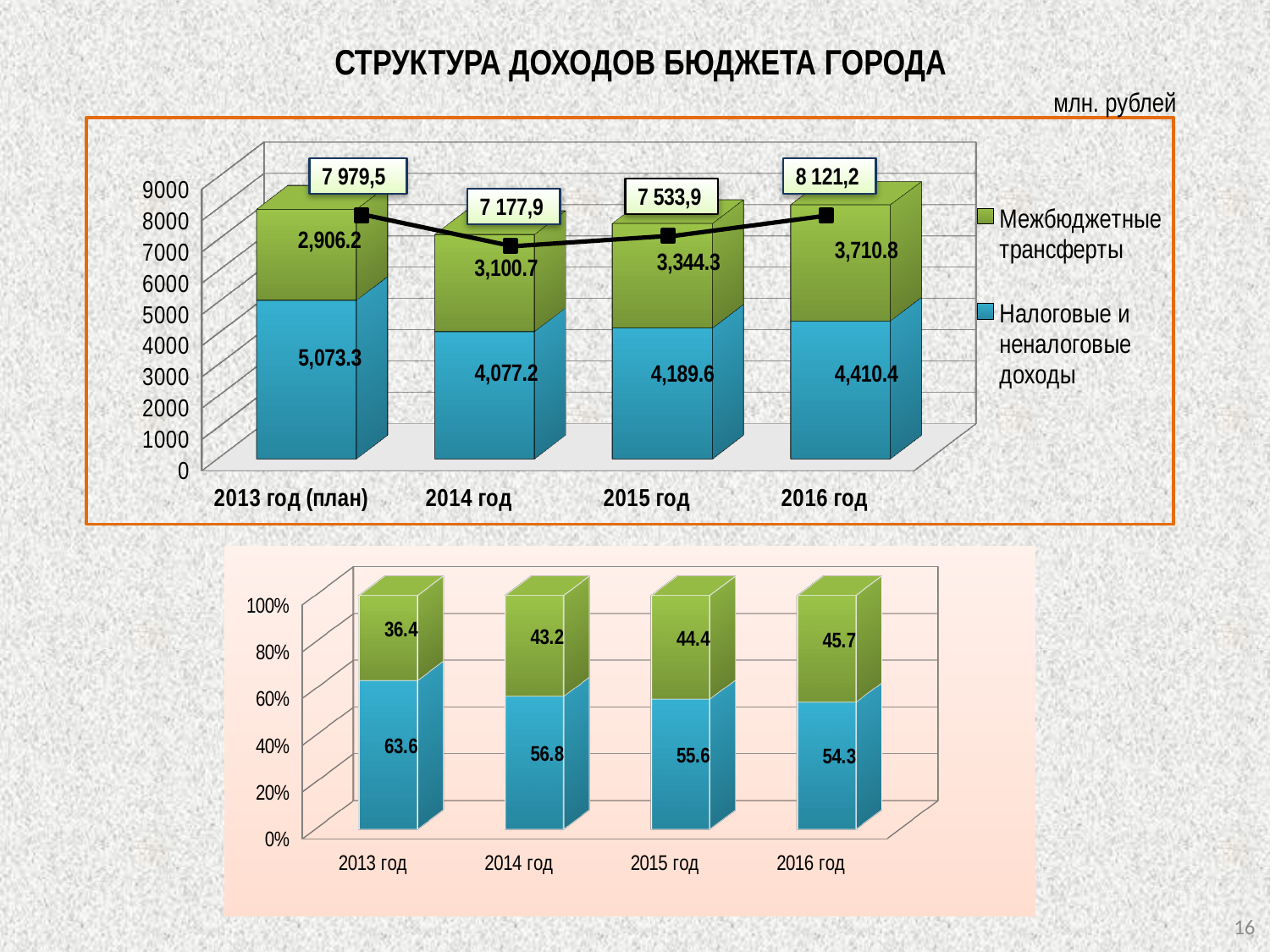
How many series does the legend of the top chart list? 2 In the bottom chart, what is the share of the green segment (Межбюджетные трансферты) for 2014 год? 43.2 In the top chart, what is the value of Межбюджетные трансферты for 2016 год? 3,710.8 In the top chart, what is the difference between Налоговые и неналоговые доходы in 2016 год and 2015 год? 220.8 How many years are shown on the x axis of the bottom chart? 4 In the top chart, is Межбюджетные трансферты larger in 2015 год or in 2014 год? 2015 год In the top chart, which year has the lowest value for Налоговые и неналоговые доходы? 2014 год What kind of chart is the bottom chart? Stacked bar chart In the top chart, what total is shown on the line for 2014 год? 7 177,9 In the top chart, what is the value of Налоговые и неналоговые доходы for 2013 год (план)? 5,073.3 In the top chart, which year has the highest value for Межбюджетные трансферты? 2016 год In the bottom chart, does the blue segment (Налоговые и неналоговые доходы) rise or fall from 2013 год to 2016 год? Fall